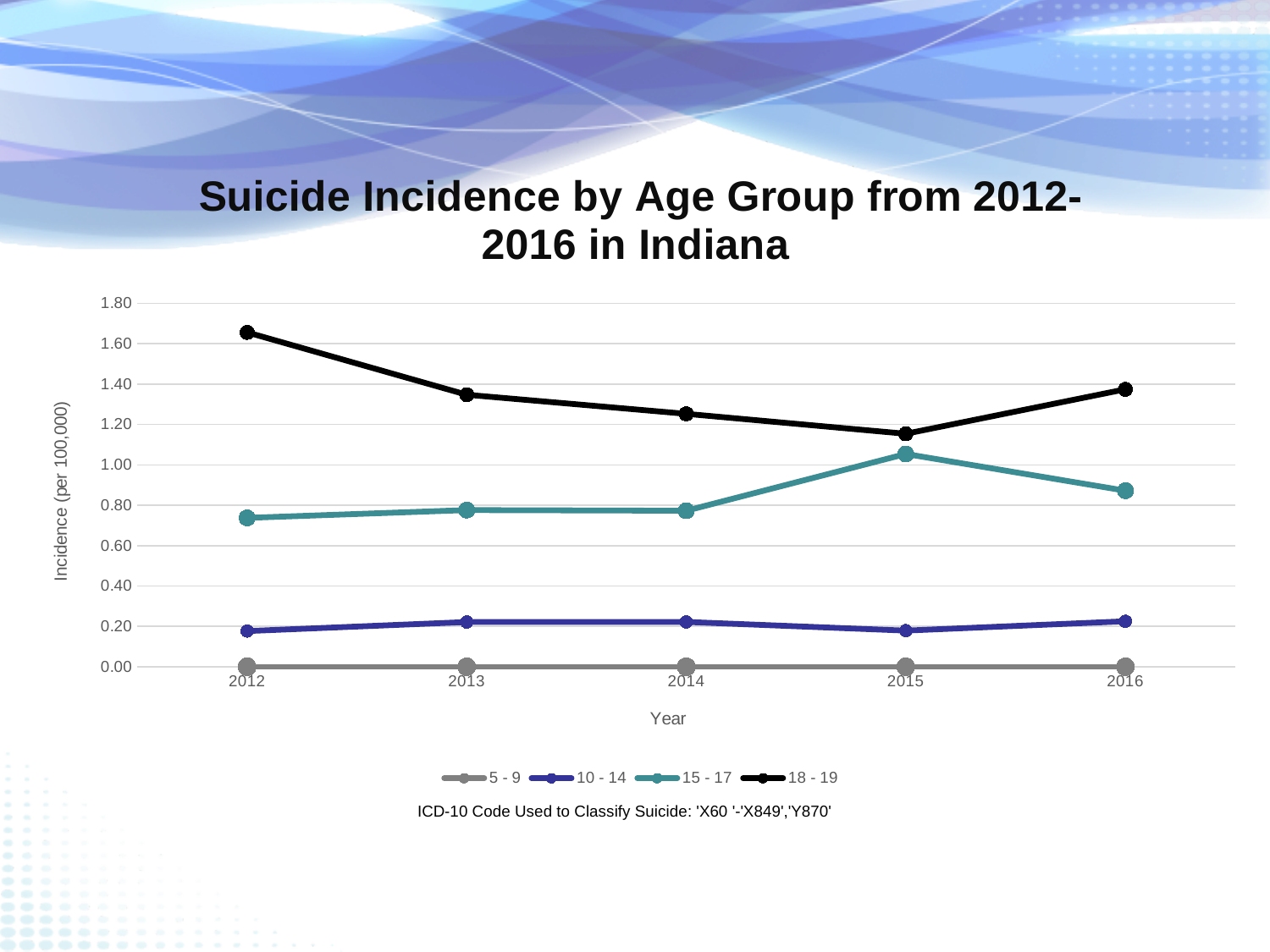
In which year is the incidence for the 18 - 19 age group lowest? 2015 Is the value for the 10 - 14 age group in 2016 greater or less than 0.40? less In which year is the incidence for the 15 - 17 age group highest? 2015 What kind of chart is shown on the slide? line chart Is the value for the 15 - 17 age group in 2012 greater or less than 0.80? less How many series does the legend list? 4 Does the incidence for the 18 - 19 age group rise or fall from 2012 to 2015? fall What is the incidence for the 5 - 9 age group in 2014? 0.00 In which year is the incidence for the 18 - 19 age group highest? 2012 Is the value for the 18 - 19 age group in 2012 greater or less than 1.40? greater In 2016, which age group has the higher incidence, 18 - 19 or 15 - 17? 18 - 19 How many years are plotted along the x axis? 5